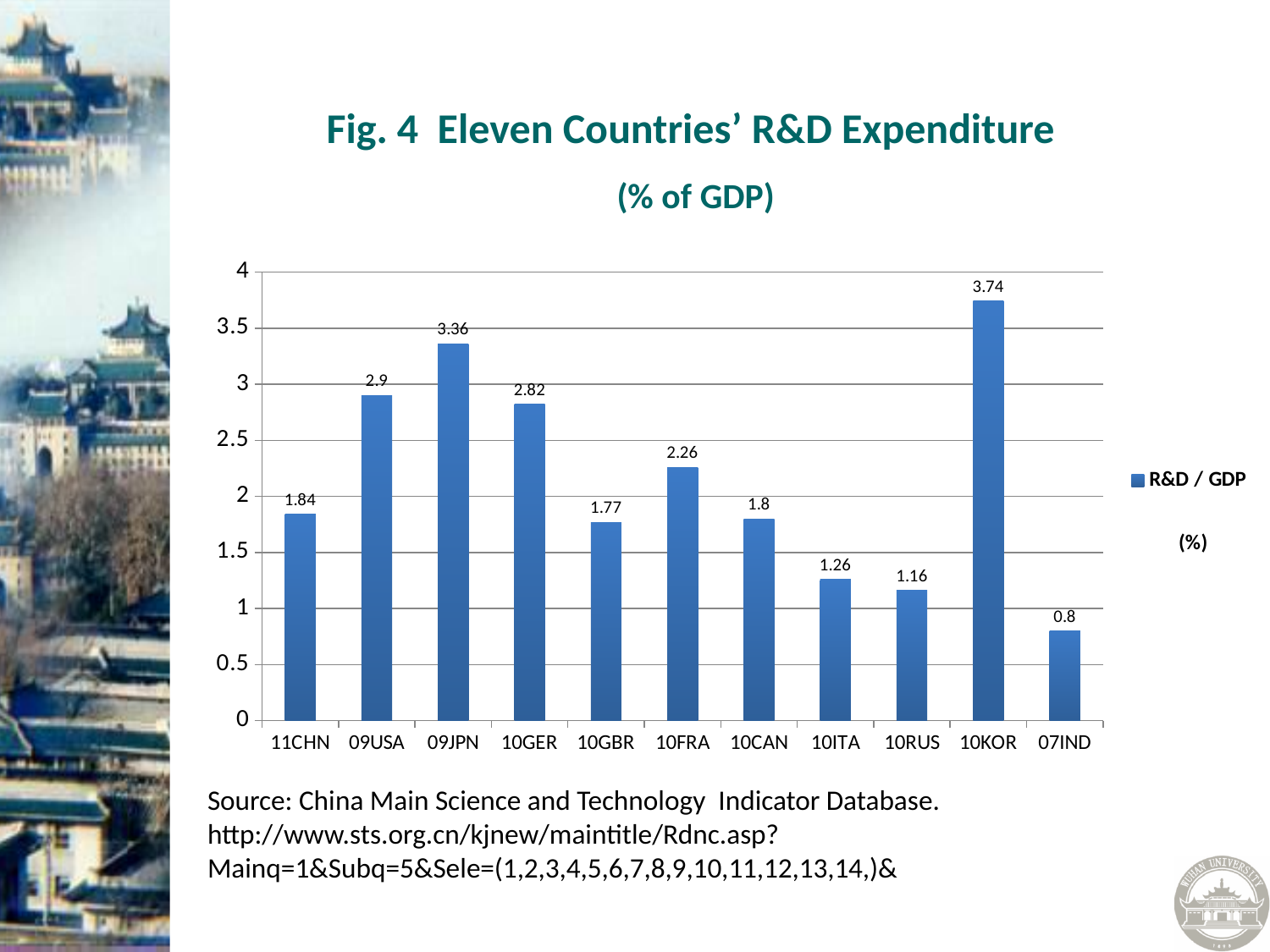
Which country has the lowest R&D / GDP value? 07IND What is the difference between the R&D / GDP values for 09USA and 10GER? 0.08 Is the value for 10ITA greater or less than 1.5? less How many countries are shown on the x axis? 11 What is the title of the chart? Fig. 4 Eleven Countries' R&D Expenditure (% of GDP) What is the R&D / GDP value for 09JPN? 3.36 Which has a larger R&D / GDP value, 10FRA or 10CAN? 10FRA What is the difference between the R&D / GDP values for 10KOR and 07IND? 2.94 What is the R&D / GDP value for 11CHN? 1.84 What is the R&D / GDP value for 10RUS? 1.16 What kind of chart is shown on the slide? bar chart Which country has the highest R&D / GDP value? 10KOR